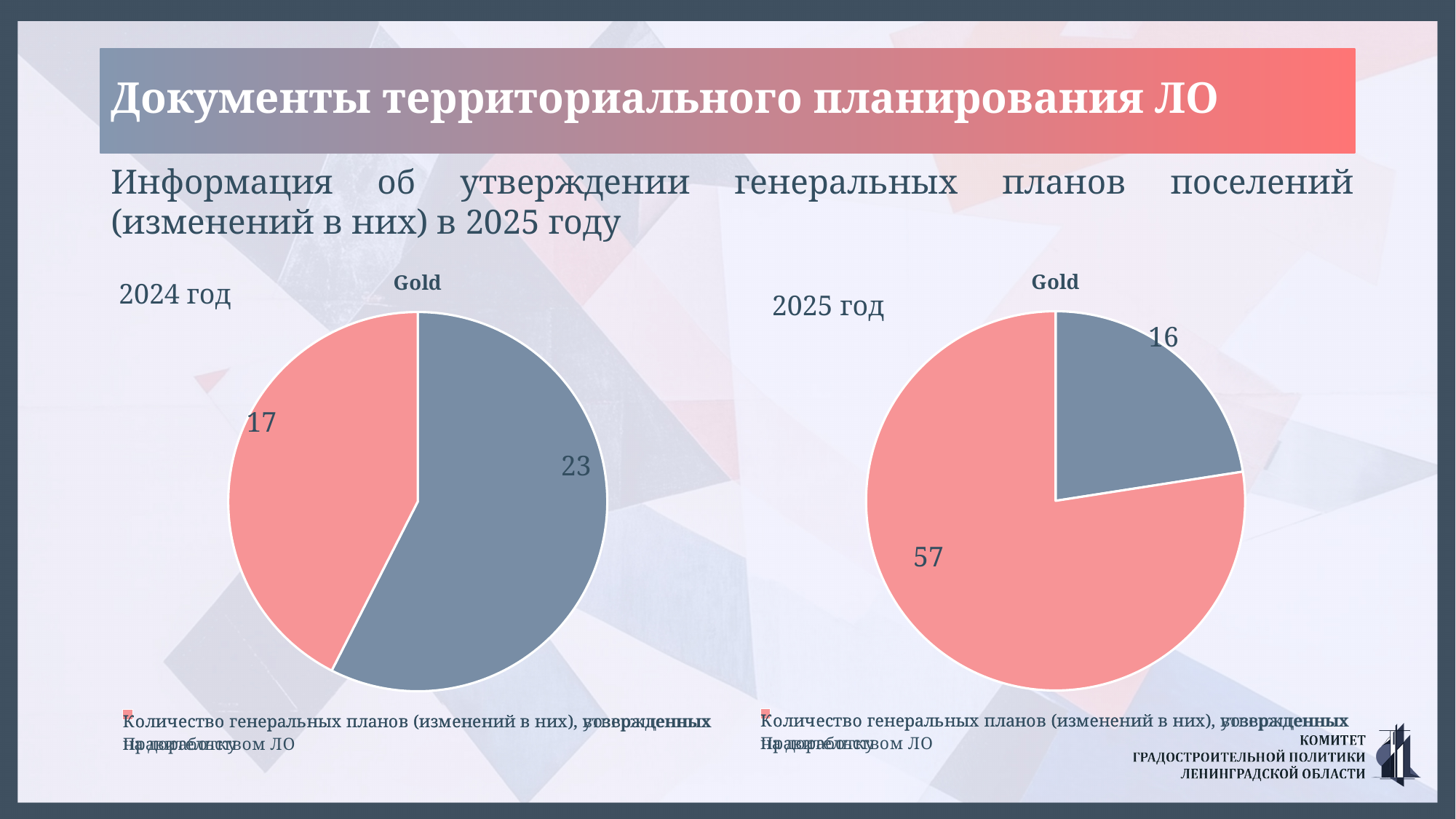
How many slices does the 2025 год pie chart have? 2 In the 2025 год pie chart, what value is shown for the blue-grey slice? 16 In the 2024 год pie chart, what share of the total does the blue-grey slice (23) represent? 57.5% In the 2025 год pie chart, which slice is the largest? The red slice (57) Which is larger: the red slice in the 2024 год chart or the red slice in the 2025 год chart? The red slice in the 2025 год chart (57) In the 2024 год pie chart, which slice is the smallest? The red slice (17) In the 2024 год pie chart, what value is shown for the red slice? 17 In the 2024 год pie chart, what value is shown for the blue-grey slice? 23 What kind of chart is used for the 2024 год data? Pie chart In the 2025 год pie chart, what value is shown for the red slice? 57 In the 2025 год pie chart, what is the difference between the two slice values? 41 In the 2024 год pie chart, what is the difference between the two slice values? 6